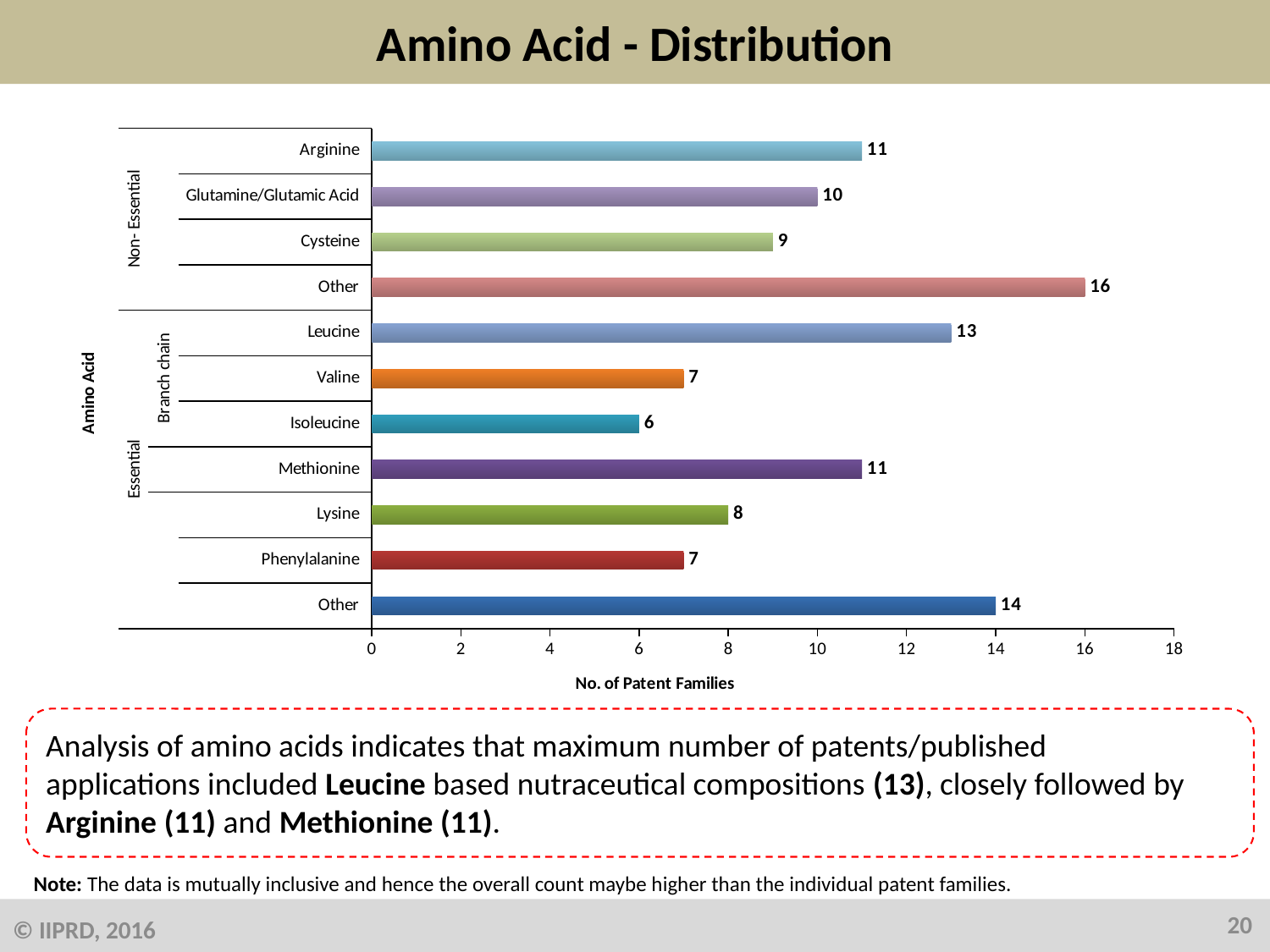
What type of chart is shown on the slide? Bar chart What is the label of the horizontal axis? No. of Patent Families What is the difference in patent families between Leucine and Valine? 6 Which amino acid category has the lowest number of patent families? Isoleucine What is the number of patent families for Isoleucine? 6 What is the number of patent families for the 'Other' category in the Non-Essential group? 16 What is the number of patent families for Glutamine/Glutamic Acid? 10 What is the number of patent families for Leucine? 13 Which has more patent families, Cysteine or Lysine? Cysteine What is the title of the chart? Amino Acid - Distribution Which bar has the highest number of patent families? Other (Non-Essential) How many bars are plotted in the chart? 11